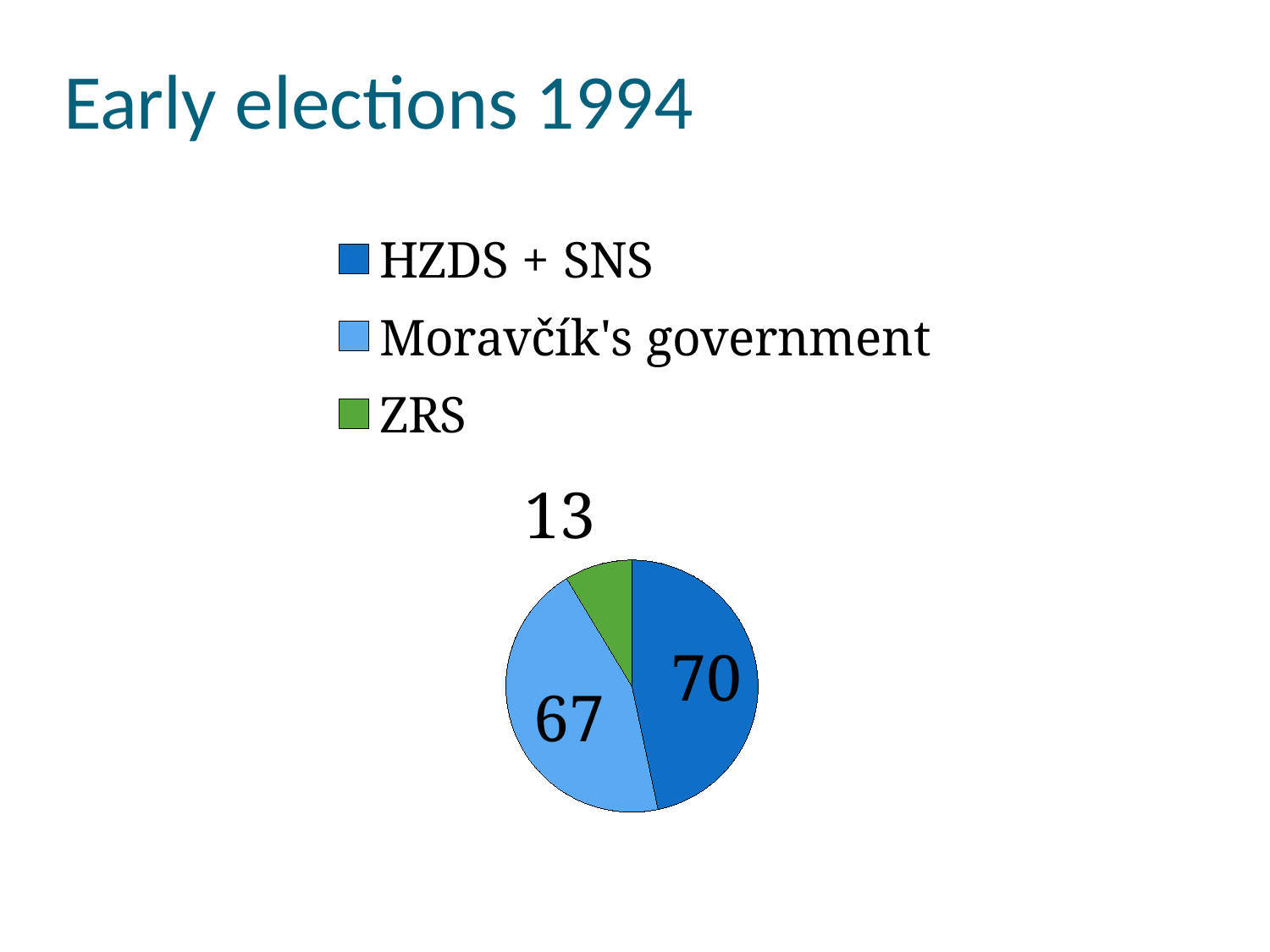
How many categories are shown in the pie chart? 3 What is the difference between the values for HZDS + SNS and Moravčík's government? 3 Which category has the smallest slice of the pie chart? ZRS Which category has the largest slice of the pie chart? HZDS + SNS What kind of chart is shown on the slide? Pie chart Which is larger, the value for HZDS + SNS or the value for ZRS? HZDS + SNS What is the difference between the values for Moravčík's government and ZRS? 54 What value is shown for Moravčík's government in the pie chart? 67 What is the title of the slide containing the pie chart? Early elections 1994 What value is shown for ZRS in the pie chart? 13 What is the total of all the values shown in the pie chart? 150 What value is shown for HZDS + SNS in the pie chart? 70